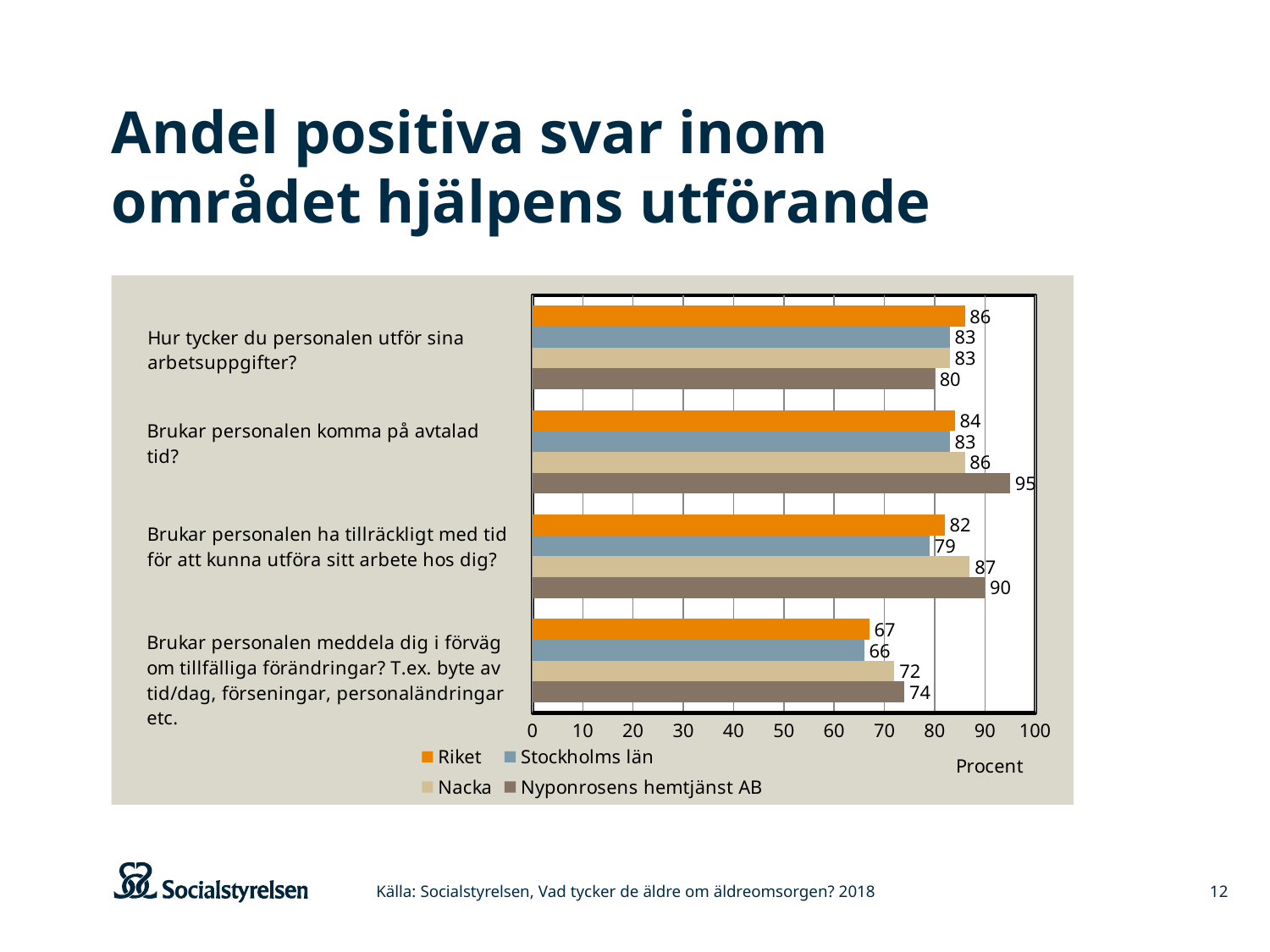
What kind of chart is shown on the slide? bar chart What is the value for Nacka for 'Brukar personalen meddela dig i förväg om tillfälliga förändringar?' 72 For 'Hur tycker du personalen utför sina arbetsuppgifter?', which is larger: Riket or Nyponrosens hemtjänst AB? Riket Which series has the highest value for 'Brukar personalen komma på avtalad tid?' Nyponrosens hemtjänst AB What label is shown on the horizontal axis of the chart? Procent What is the value for Stockholms län for 'Brukar personalen ha tillräckligt med tid för att kunna utföra sitt arbete hos dig?' 79 What is the value for Riket for 'Hur tycker du personalen utför sina arbetsuppgifter?' 86 How many question categories are plotted on the chart? 4 What is the value for Nyponrosens hemtjänst AB for 'Brukar personalen komma på avtalad tid?' 95 How many series does the legend list? 4 Which series has the lowest value for 'Brukar personalen meddela dig i förväg om tillfälliga förändringar?' Stockholms län What is the difference between Nyponrosens hemtjänst AB and Riket for 'Brukar personalen komma på avtalad tid?' 11